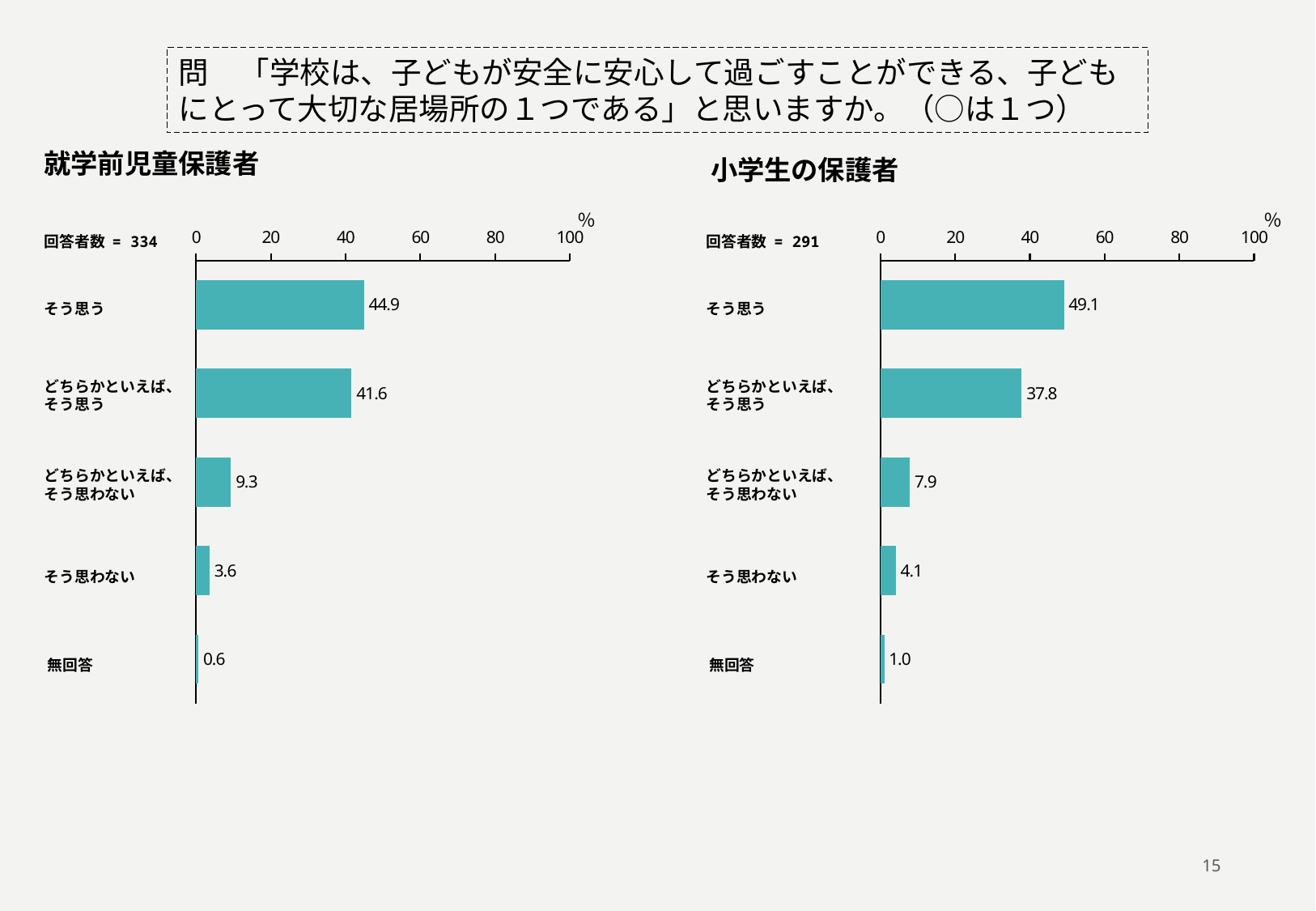
How many categories are shown in the 小学生の保護者 chart? 5 In the 小学生の保護者 chart, what is the value for 無回答? 1.0 In the 就学前児童保護者 chart, is the value for どちらかといえば、そう思う greater or less than 40? greater In the 就学前児童保護者 chart, which category has the highest value? そう思う In the 就学前児童保護者 chart, what is the value for そう思う? 44.9 Which chart has the larger value for そう思わない, 就学前児童保護者 or 小学生の保護者? 小学生の保護者 What is the number of respondents (回答者数) shown for the 小学生の保護者 chart? 291 In the 小学生の保護者 chart, which category has the lowest value? 無回答 In the 就学前児童保護者 chart, what is the difference between そう思う and どちらかといえば、そう思う? 3.3 What kind of chart is the 就学前児童保護者 chart? bar chart In the 小学生の保護者 chart, what is the value for どちらかといえば、そう思う? 37.8 In the 小学生の保護者 chart, what is the difference between そう思う and どちらかといえば、そう思う? 11.3